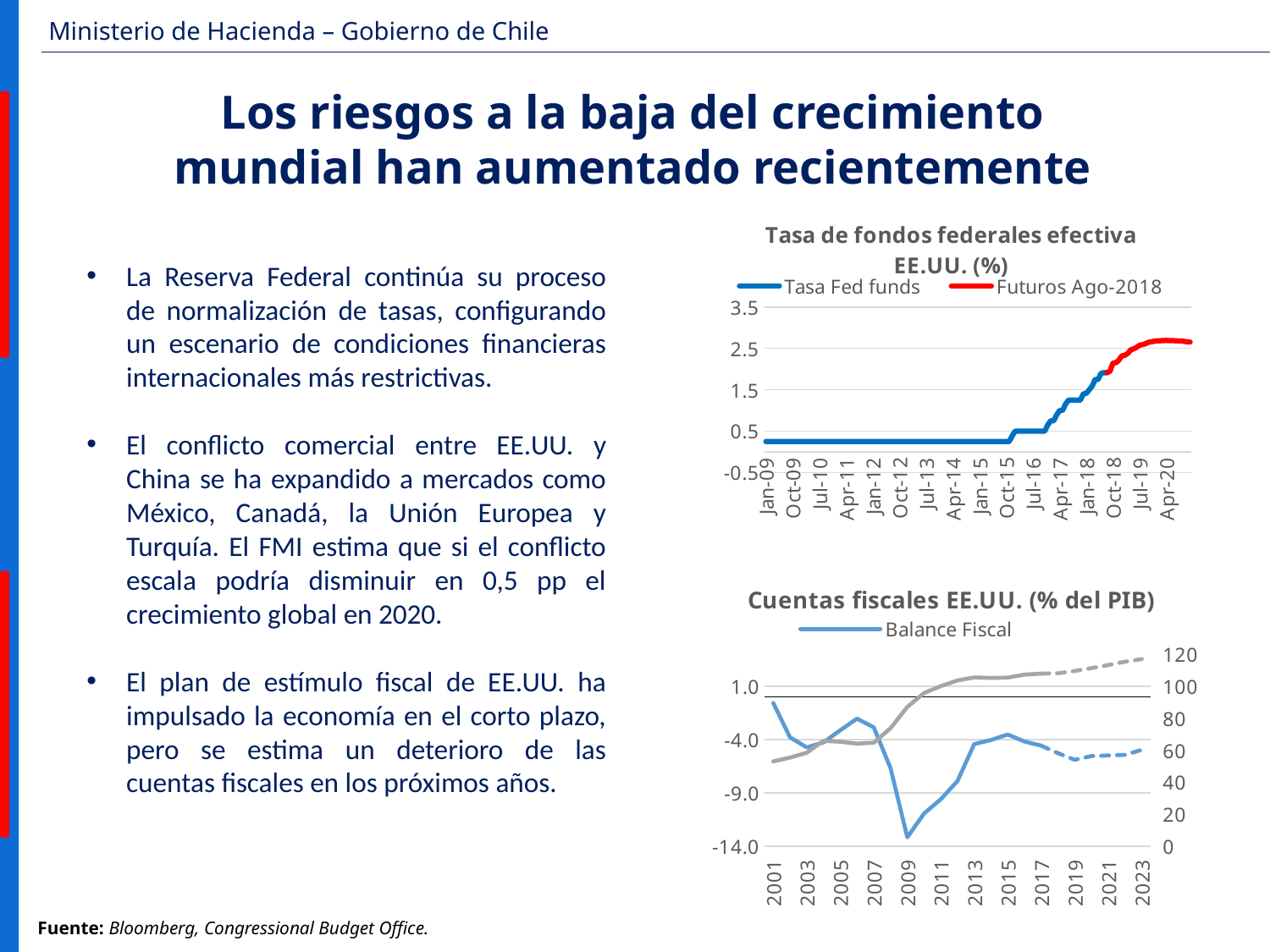
In the 'Cuentas fiscales EE.UU. (% del PIB)' chart, is the Balance Fiscal value for 2009 greater or less than -9.0? less How many series does the legend of the 'Tasa de fondos federales efectiva EE.UU. (%)' chart list? 2 What kind of chart is the 'Cuentas fiscales EE.UU. (% del PIB)' chart? line chart How many series does the legend of the 'Cuentas fiscales EE.UU. (% del PIB)' chart list? 1 In the 'Tasa de fondos federales efectiva EE.UU. (%)' chart, is the value of Futuros Ago-2018 at Apr-20 greater or less than 1.5? greater In the 'Tasa de fondos federales efectiva EE.UU. (%)' chart, which series is drawn in red? Futuros Ago-2018 In the 'Cuentas fiscales EE.UU. (% del PIB)' chart, is the Balance Fiscal value for 2001 greater or less than -4.0? greater In the 'Cuentas fiscales EE.UU. (% del PIB)' chart, does the Balance Fiscal series rise or fall between 2007 and 2009? fall What is the title of the lower chart on the slide? Cuentas fiscales EE.UU. (% del PIB) What kind of chart is the 'Tasa de fondos federales efectiva EE.UU. (%)' chart? line chart In the 'Tasa de fondos federales efectiva EE.UU. (%)' chart, does the Tasa Fed funds series rise or fall between Oct-15 and Oct-18? rise